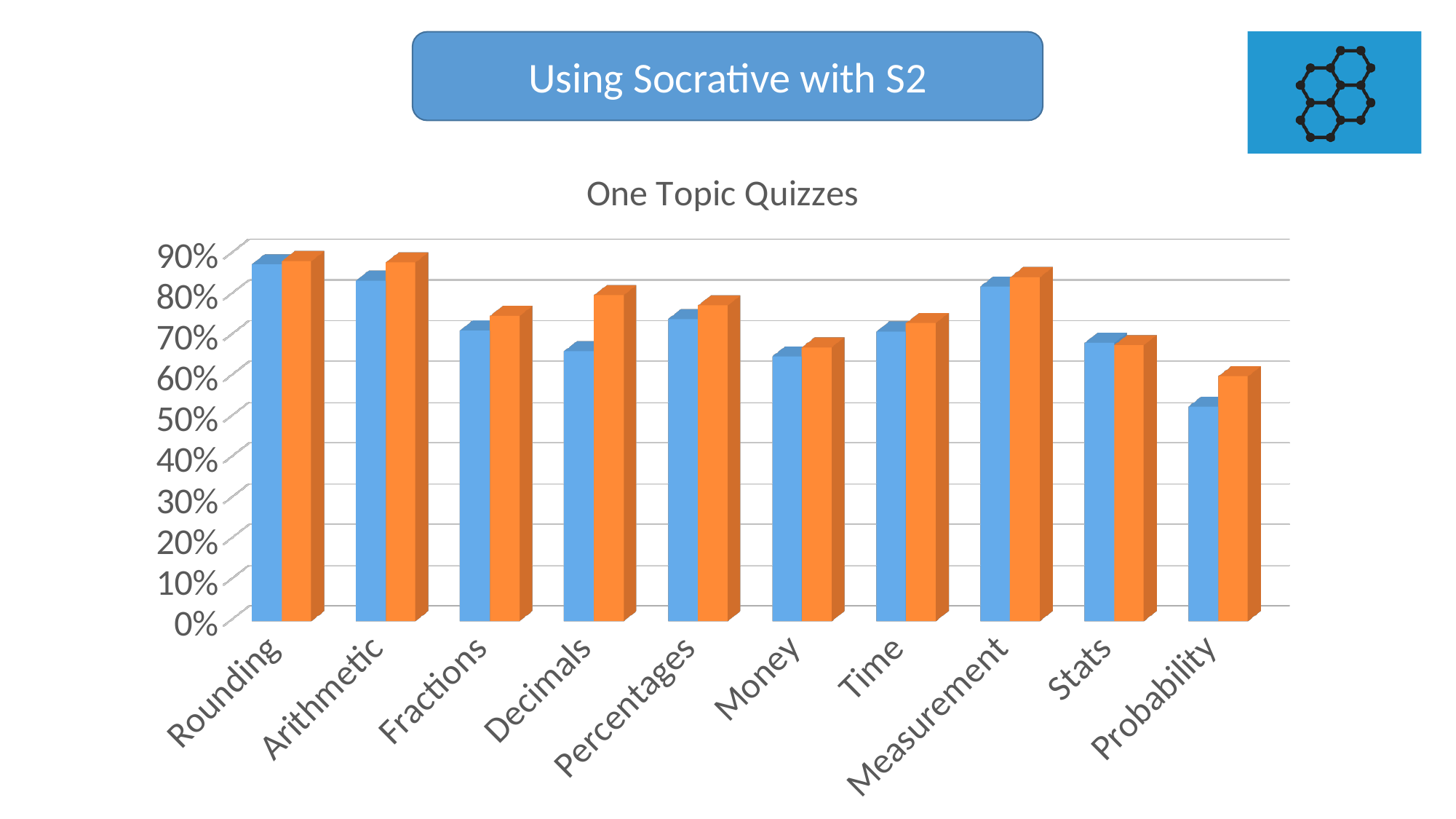
Is the blue bar for Money greater or less than 70%? less What type of chart is shown on the slide? bar chart Is the blue bar for Rounding greater or less than 80%? greater Which topic has the lowest value for the orange bars? Probability How many topic categories are shown on the x axis of the chart? 10 Is the orange bar for Measurement greater or less than 80%? greater What is the title of the chart? One Topic Quizzes Which topic has the lowest value for the blue bars? Probability For Probability, which bar is larger, the blue one or the orange one? orange Which topic has the highest value for the blue bars? Rounding For Decimals, which bar is larger, the blue one or the orange one? orange